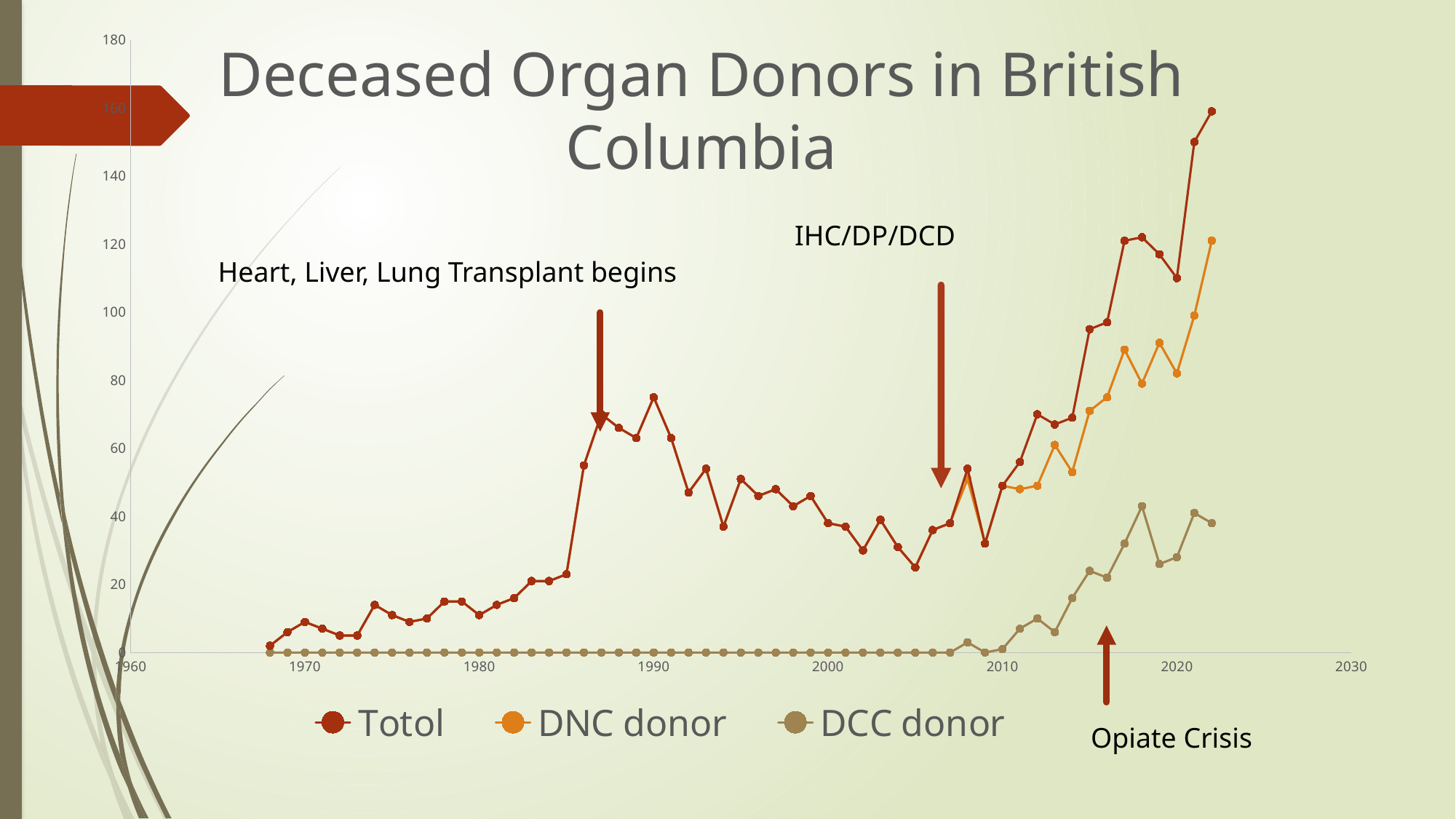
Which series has the lowest values across the chart? DCC donor How many series does the legend list? 3 Is the value for Totol in 2022 greater or less than 140? greater In 2020, which is larger: Totol or DCC donor? Totol Does the Totol series generally rise or fall between 2010 and 2022? Rise Is the value for Totol in 2005 greater or less than 40? less What is the title of the chart? Deceased Organ Donors in British Columbia Which series are listed in the legend? Totol, DNC donor, DCC donor What kind of chart is shown on the slide? Line chart Which series reaches the highest value on the chart? Totol Is the value for DCC donor in 2000 greater or less than 20? less